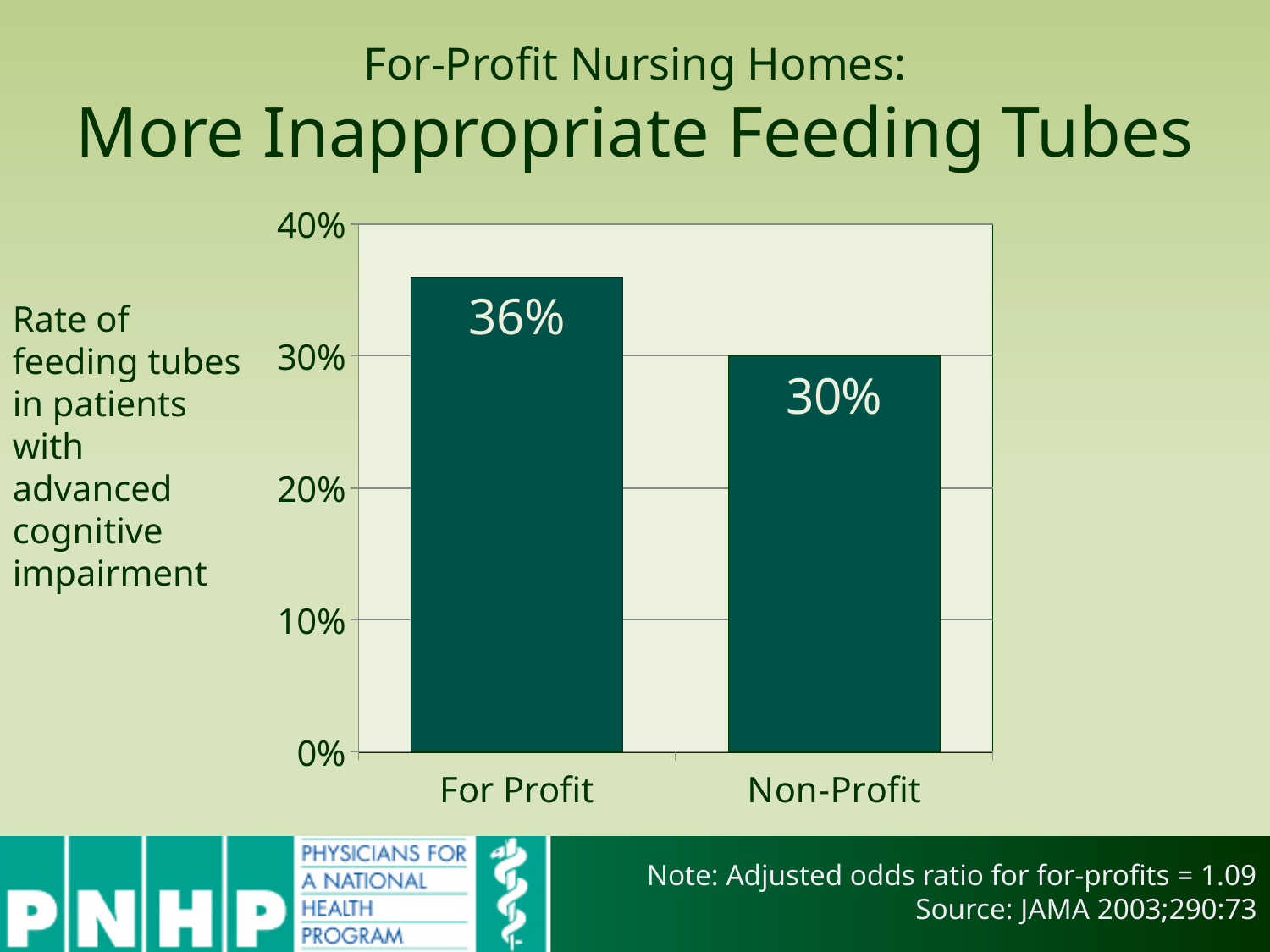
What is the rate of feeding tubes for Non-Profit nursing homes? 30% Which category has the highest rate of feeding tubes? For Profit Which is larger, the rate for For Profit or for Non-Profit? For Profit What is the rate of feeding tubes for For Profit nursing homes? 36% Which category has the lowest rate of feeding tubes? Non-Profit What is the difference between the For Profit and Non-Profit feeding tube rates? 6% What kind of chart is shown on the slide? Bar chart Is the value for Non-Profit greater or less than 40%? less How many categories are shown on the chart? 2 What is the highest value shown on the y axis? 40% What is the source cited for the chart data? JAMA 2003;290:73 Is the value for For Profit greater or less than 30%? greater